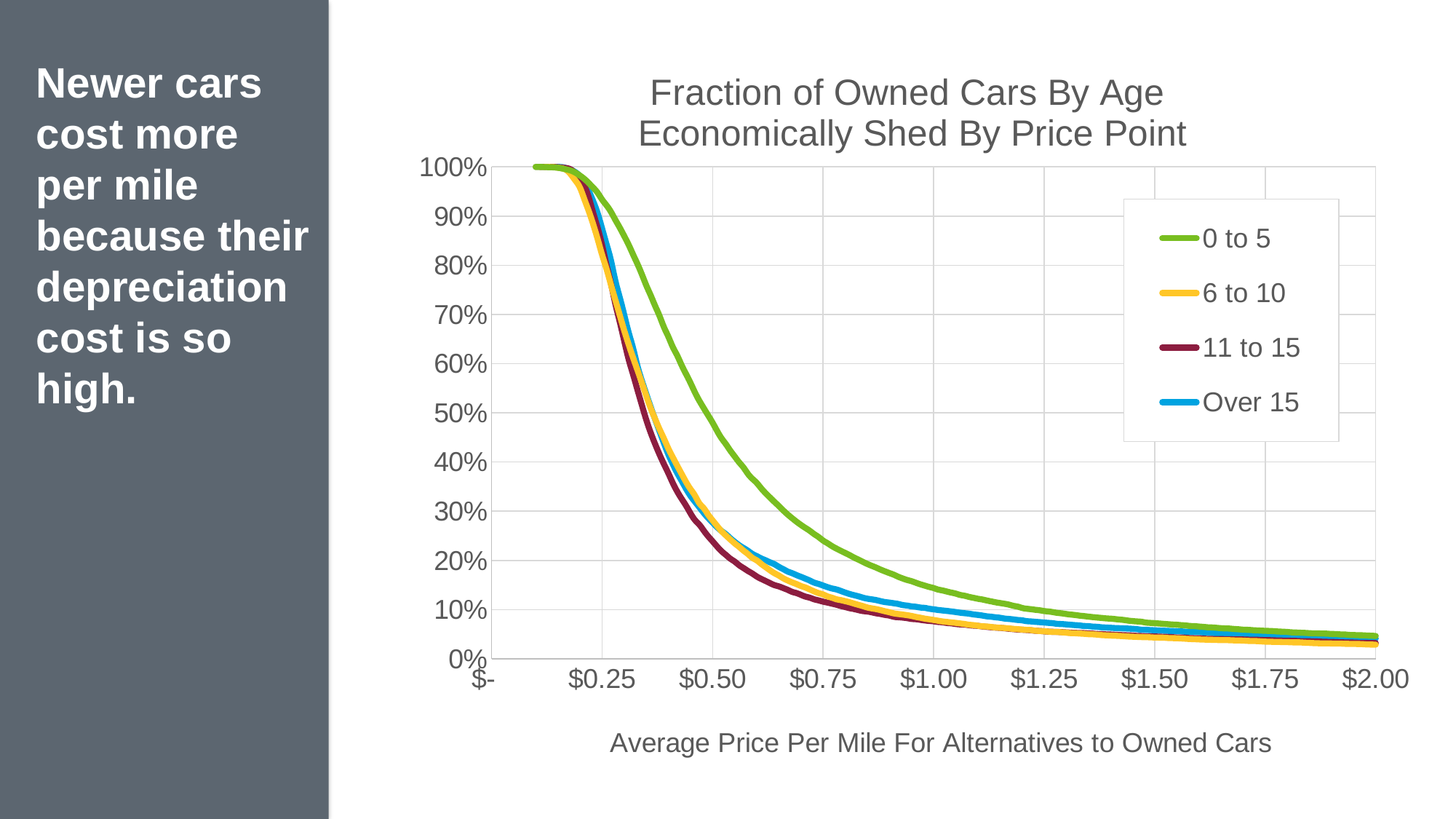
Which series has the highest value at $0.50 per mile? 0 to 5 How many series does the legend list? 4 At $0.75 per mile, which is larger: the value for 0 to 5 or the value for Over 15? 0 to 5 Is the value for the 0 to 5 series at $1.00 greater or less than 10%? greater Which series has the lowest value at $0.50 per mile? 11 to 15 What is the title of the chart? Fraction of Owned Cars By Age Economically Shed By Price Point Do the values for the 0 to 5 series rise or fall as the price per mile increases along the x axis? fall At $0.50 per mile, which is larger: the value for 11 to 15 or the value for 0 to 5? 0 to 5 Is the value for the 6 to 10 series at $1.00 greater or less than 10%? less What kind of chart is shown on the slide? line chart Is the value for the 0 to 5 series at $0.50 greater or less than 50%? less What is the label of the x axis? Average Price Per Mile For Alternatives to Owned Cars